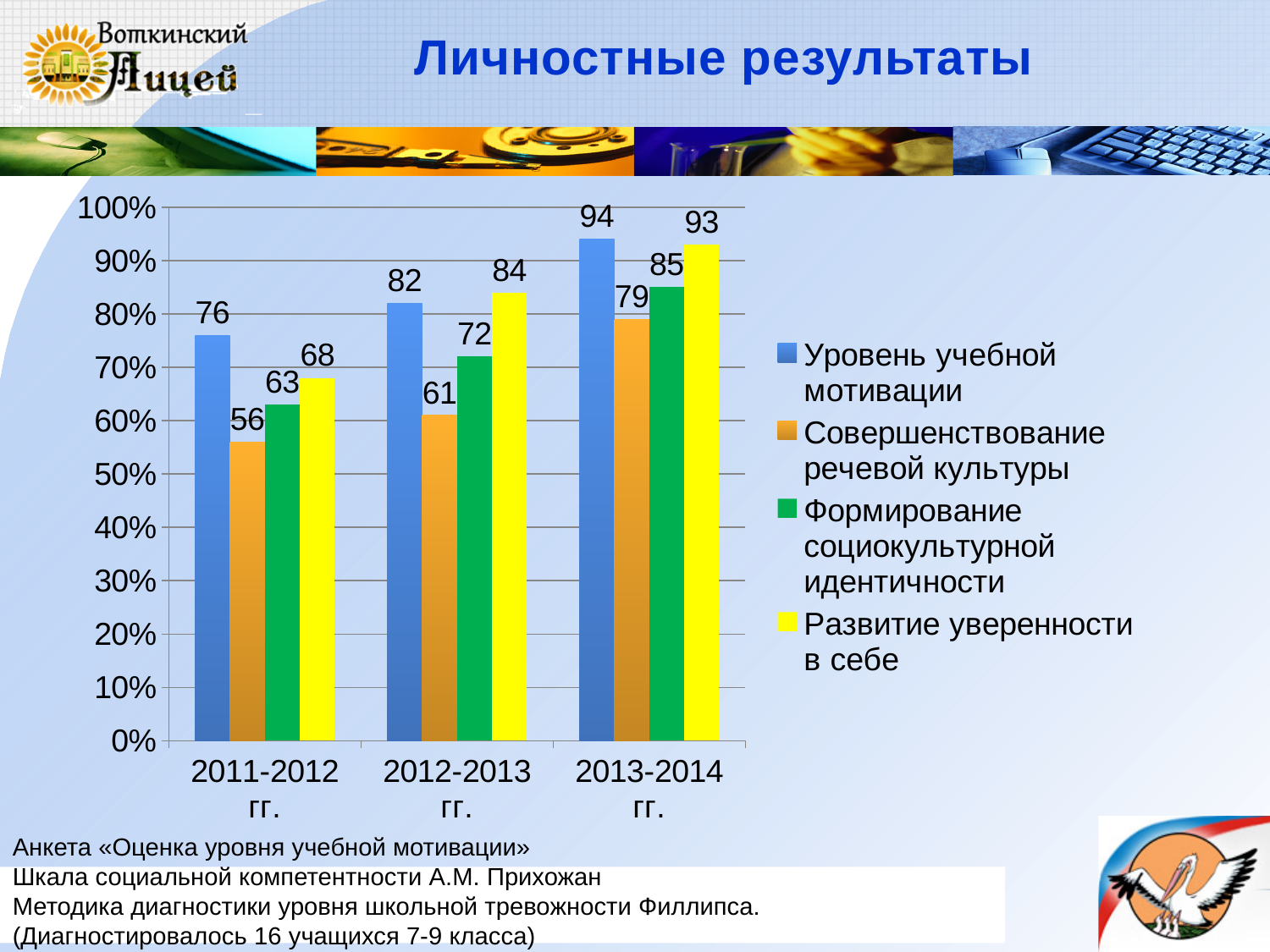
Which series has the lowest value in 2011-2012 гг.? Совершенствование речевой культуры Which series has the highest value in 2013-2014 гг.? Уровень учебной мотивации How many series does the legend list? 4 What is the value for Формирование социокультурной идентичности in 2012-2013 гг.? 72 What is the value for Развитие уверенности в себе in 2013-2014 гг.? 93 What is the value for Уровень учебной мотивации in 2011-2012 гг.? 76 Do the values for Совершенствование речевой культуры rise or fall from 2011-2012 гг. to 2013-2014 гг.? Rise What kind of chart is shown on the slide? Bar chart What is the difference between the values for Уровень учебной мотивации in 2013-2014 гг. and 2011-2012 гг.? 18 What is the value for Совершенствование речевой культуры in 2012-2013 гг.? 61 Which is larger: Развитие уверенности в себе in 2012-2013 гг. or Уровень учебной мотивации in 2012-2013 гг.? Развитие уверенности в себе How many categories are shown on the x axis? 3